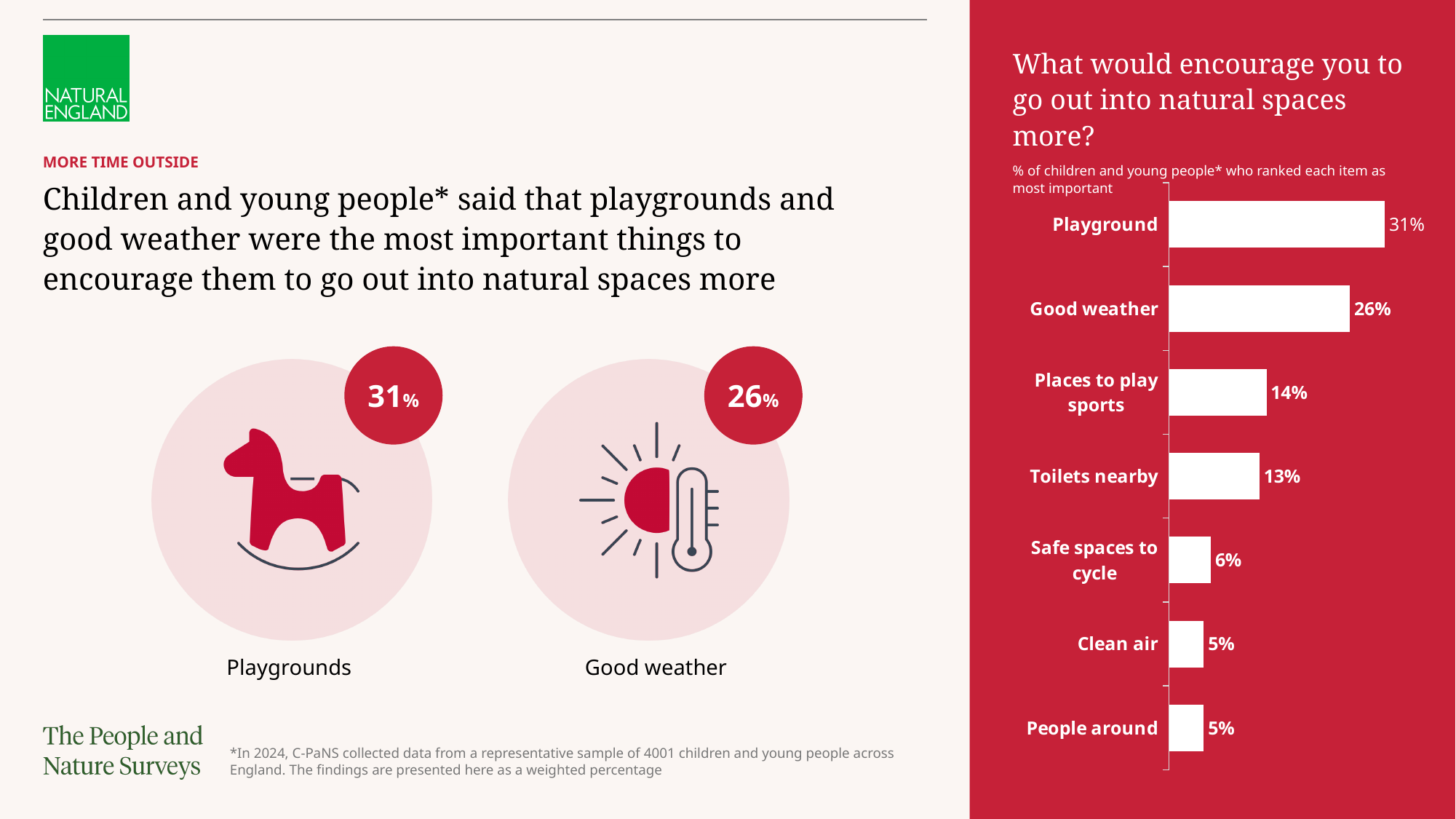
Which category has the highest value in the bar chart? Playground How many categories are shown in the bar chart? 7 What colour are the bars in the chart? White What is the value for Toilets nearby in the bar chart? 13% Which is larger, the value for Good weather or the value for Places to play sports? Good weather What is the title of the bar chart? What would encourage you to go out into natural spaces more? What is the value for Safe spaces to cycle? 6% Do the values rise or fall going down the bar chart from Playground to People around? Fall What is the difference between Places to play sports and Toilets nearby? 1% What kind of chart is shown on the right of the slide? Bar chart What is the difference between the values for Playground and Good weather? 5% What percentage of children and young people ranked Playground as most important? 31%